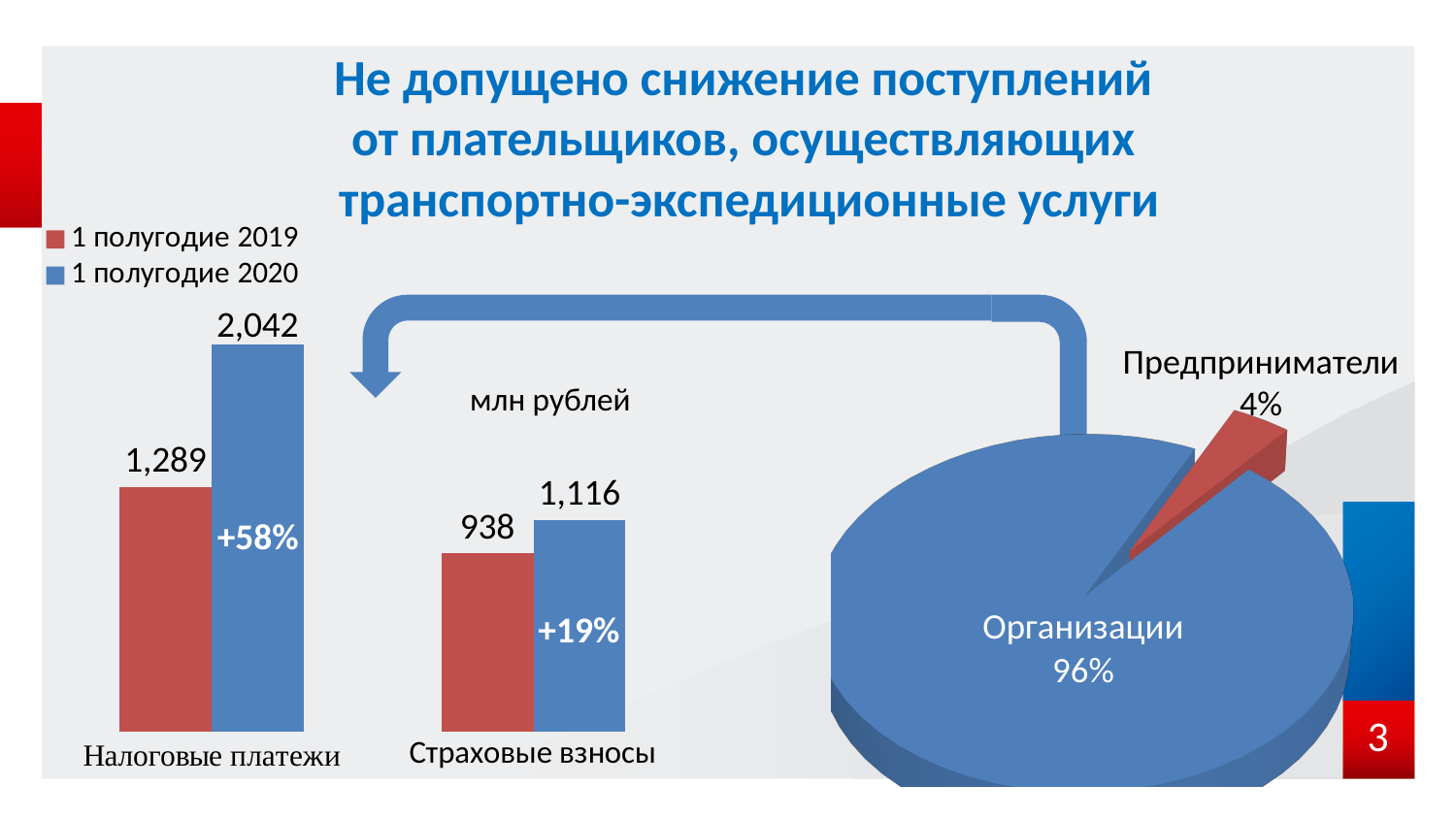
In the bar chart, what is the difference between the 1 полугодие 2020 and 1 полугодие 2019 values for Страховые взносы? 178 How many series does the legend of the bar chart list? 2 In the bar chart, what is the difference between the 1 полугодие 2020 and 1 полугодие 2019 values for Налоговые платежи? 753 In the bar chart, what is the value for Налоговые платежи in 1 полугодие 2019? 1,289 What kind of chart is the chart on the right of the slide? Pie chart In the bar chart, which is larger for Страховые взносы: the 1 полугодие 2019 value or the 1 полугодие 2020 value? 1 полугодие 2020 In the bar chart, what is the value for Налоговые платежи in 1 полугодие 2020? 2,042 In the pie chart, what share does Организации have? 96% In the bar chart, what is the value for Страховые взносы in 1 полугодие 2019? 938 In the pie chart, what share does Предприниматели have? 4% What kind of chart is the chart on the left of the slide? Bar chart In the bar chart, which category has the highest value in 1 полугодие 2020? Налоговые платежи